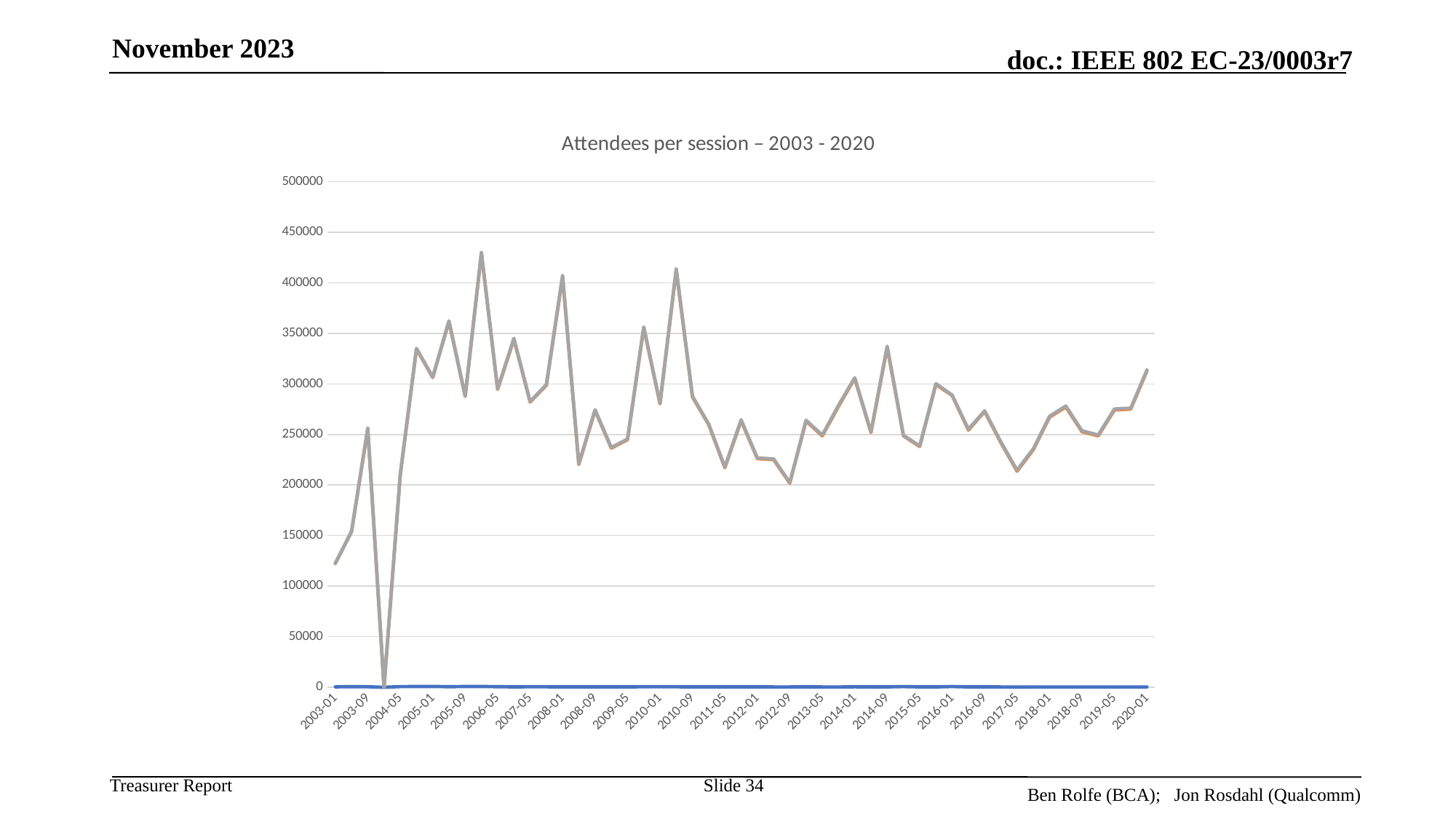
What kind of chart is shown on the slide? line chart What is the title of the chart? Attendees per session – 2003 - 2020 Is the value for 2017-05 greater or less than 250000? less Is the value for 2020-01 greater or less than 300000? greater Is the value for 2003-01 greater or less than 150000? less Between 2003-01 and 2003-09, does the value rise or fall? rise Which is larger, the value for 2003-01 or the value for 2020-01? 2020-01 What is the highest value shown on the vertical axis of the chart? 500000